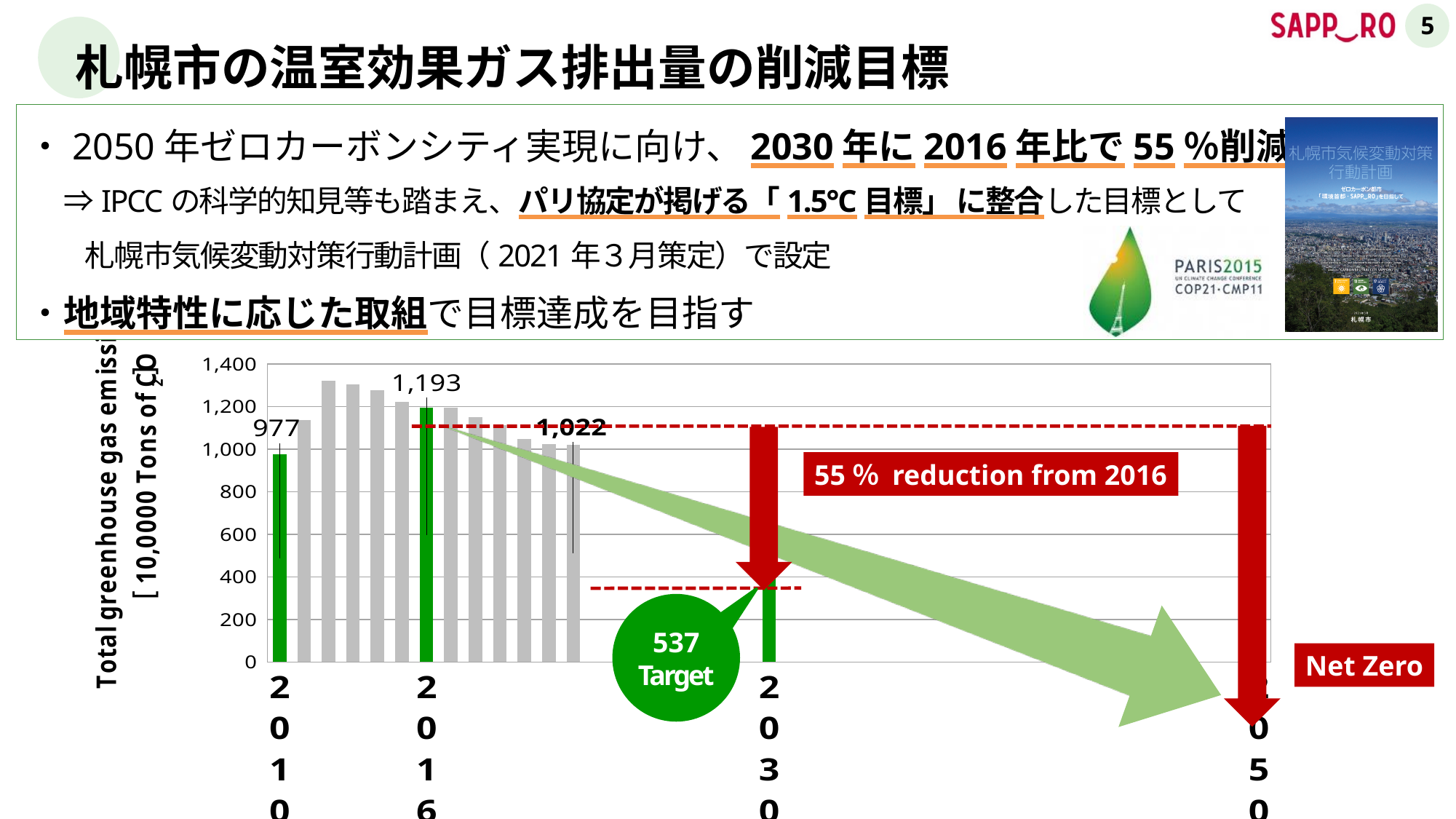
What kind of chart is shown on the slide? bar chart Which year has the larger emissions value, 2010 or 2016? 2016 Is the value for 2010 greater or less than 1,000? less What is the target value shown for 2030? 537 What is the total greenhouse gas emissions value shown for 2010? 977 What is the difference between the 2016 value and the 2010 value? 216 What is the total greenhouse gas emissions value shown for 2016? 1,193 Is the value for 2016 greater or less than 1,000? greater Do the values fall or rise from 2016 to the 2030 target? fall By how much is the 2030 target lower than the 2016 value? 656 What label is shown for the 2050 goal on the chart? Net Zero What percentage reduction from 2016 is stated in the red box on the chart? 55 %